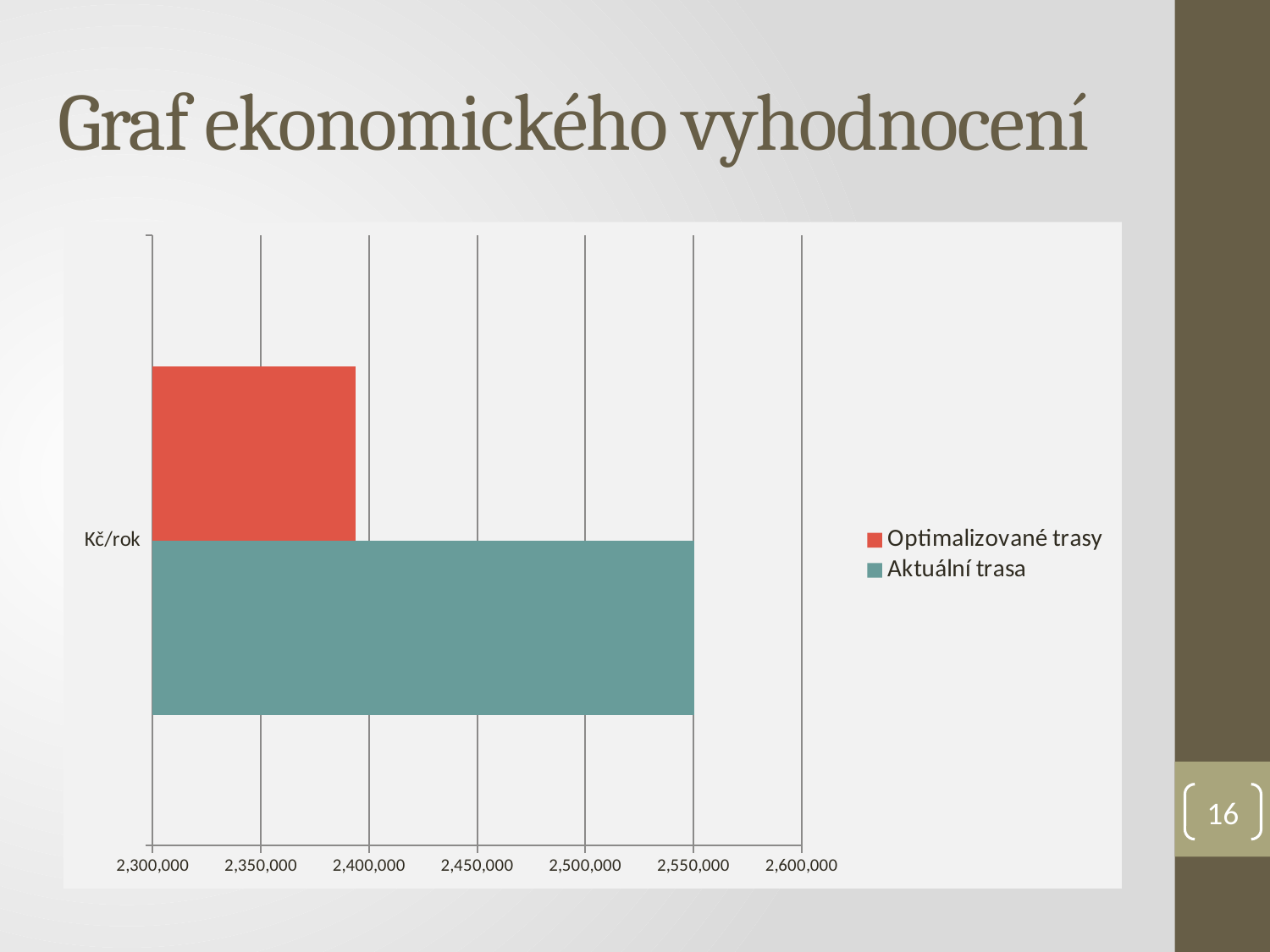
What kind of chart is shown on the slide? bar chart What is the title of the slide containing the chart? Graf ekonomického vyhodnocení Is the value for Optimalizované trasy greater or less than 2,400,000? less Which series is shown in red in the legend? Optimalizované trasy How many series does the legend list? 2 Which series has the higher value for Kč/rok? Aktuální trasa Which series has the lower value for Kč/rok? Optimalizované trasy Is the value for Optimalizované trasy greater or less than 2,350,000? greater How many categories are shown on the vertical axis? 1 Is the value for Optimalizované trasy larger or smaller than the value for Aktuální trasa? smaller What value does the bar for Aktuální trasa reach on the horizontal axis? 2,550,000 Is the value for Aktuální trasa greater or less than 2,500,000? greater